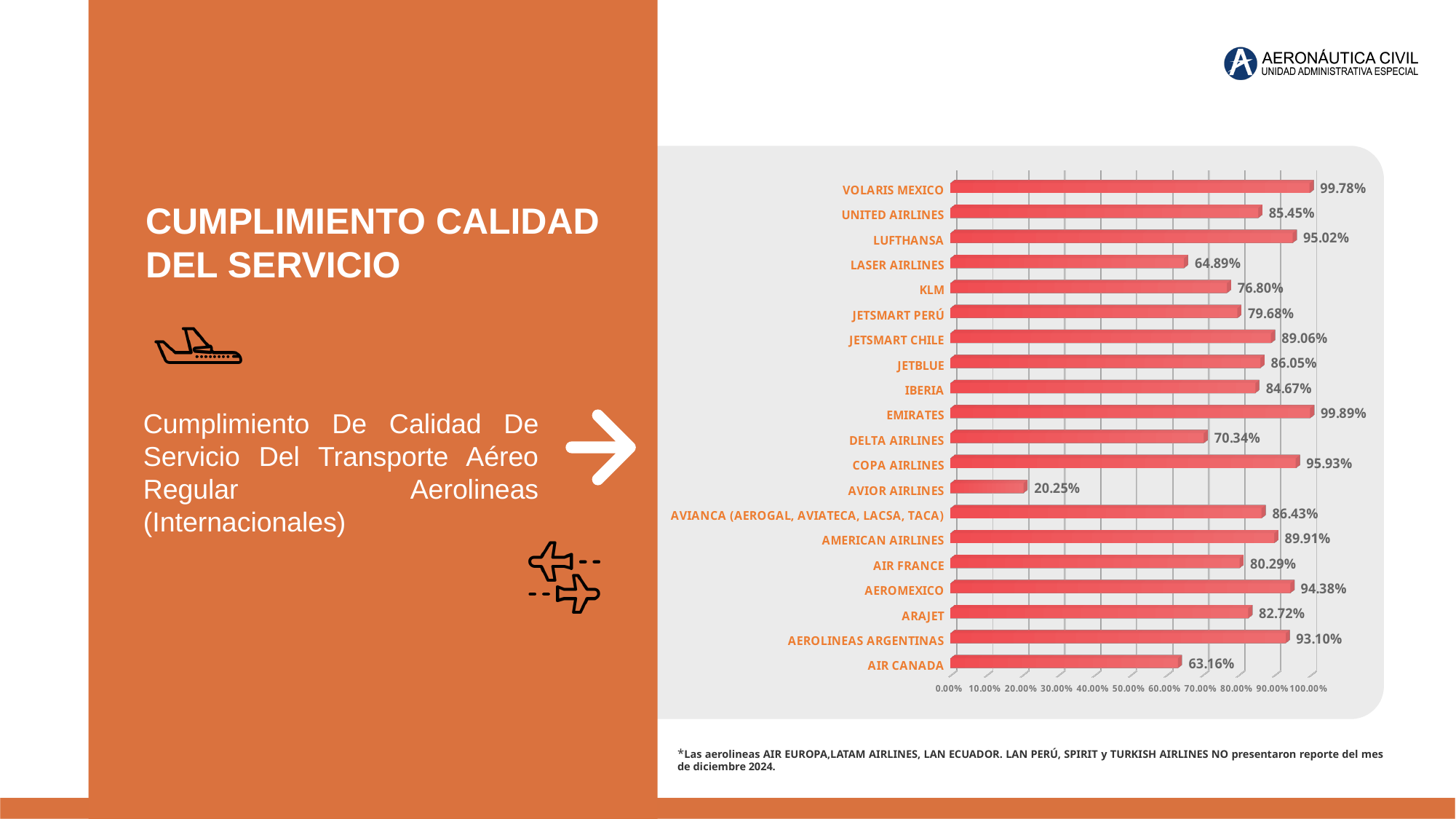
What is the value for AVIANCA (AEROGAL, AVIATECA, LACSA, TACA)? 86.43% What kind of chart is shown on the slide? Bar chart Which airline has the highest value? EMIRATES How many airlines are shown in the chart? 20 What is the value for AVIOR AIRLINES? 20.25% What is the difference between the values for COPA AIRLINES and DELTA AIRLINES? 25.59 percentage points Which airline has the lowest value? AVIOR AIRLINES Which has a larger value, AEROMEXICO or ARAJET? AEROMEXICO What is the value for AIR CANADA? 63.16% What is the difference between the values for LUFTHANSA and LASER AIRLINES? 30.13 percentage points What is the value for LUFTHANSA? 95.02% Is the value for KLM greater or less than 70.00%? greater